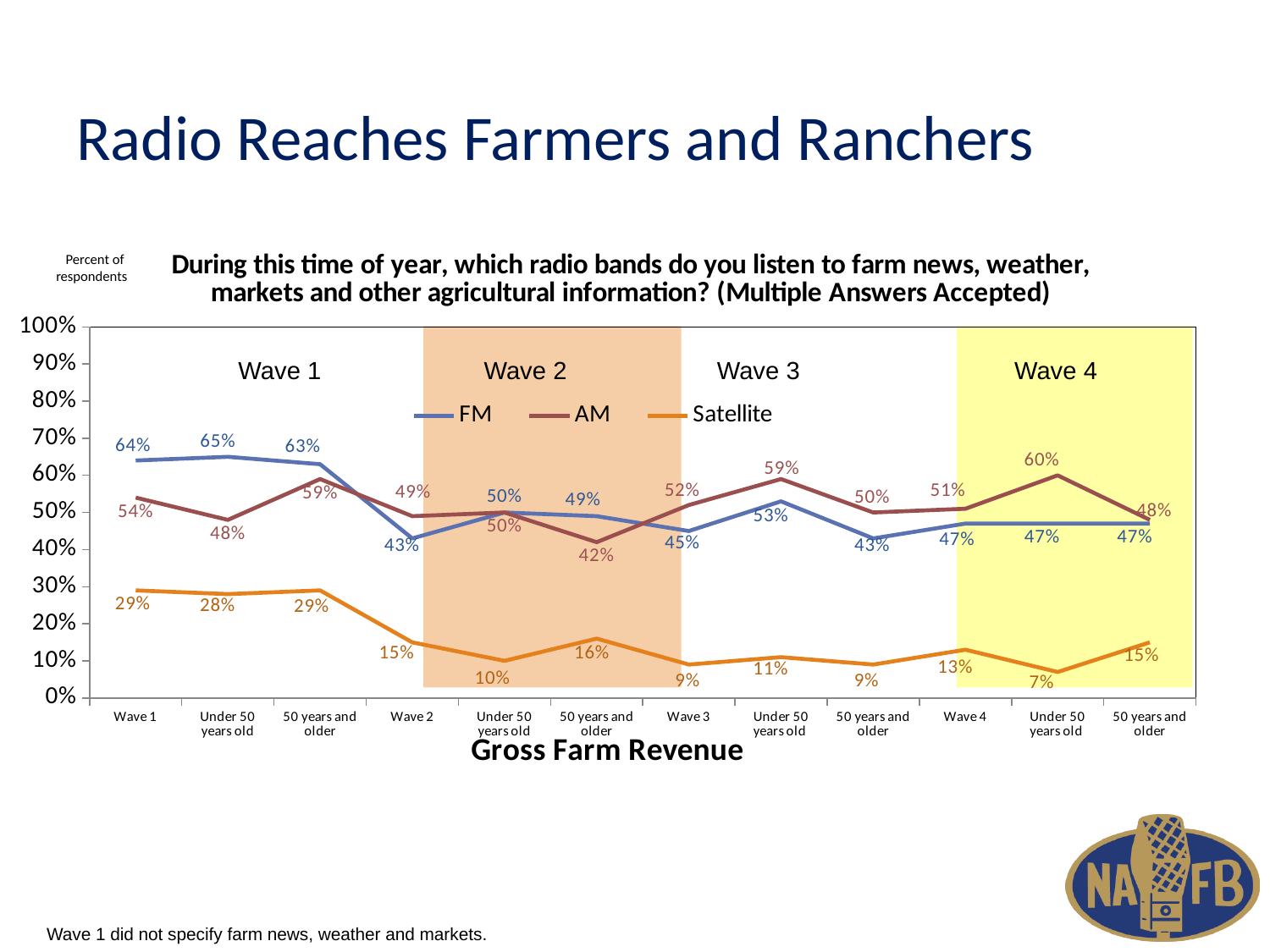
What is the Satellite value for 'Under 50 years old' in the Wave 4 section? 7% Does the Satellite series rise or fall from Wave 1 to Wave 2? Fall Which category has the highest FM value? Under 50 years old (Wave 1) What type of chart is shown on the slide? Line chart How many series does the legend list? 3 What is the AM value for '50 years and older' in the Wave 2 section? 42% What is the difference between the AM and FM values for 'Under 50 years old' in the Wave 4 section? 13% At the Wave 3 point, which is larger, the FM value or the AM value? AM How many categories are shown on the x axis? 12 What is the x-axis title of the chart? Gross Farm Revenue Which category has the lowest Satellite value? Under 50 years old (Wave 4) What is the FM value at the Wave 1 point? 64%